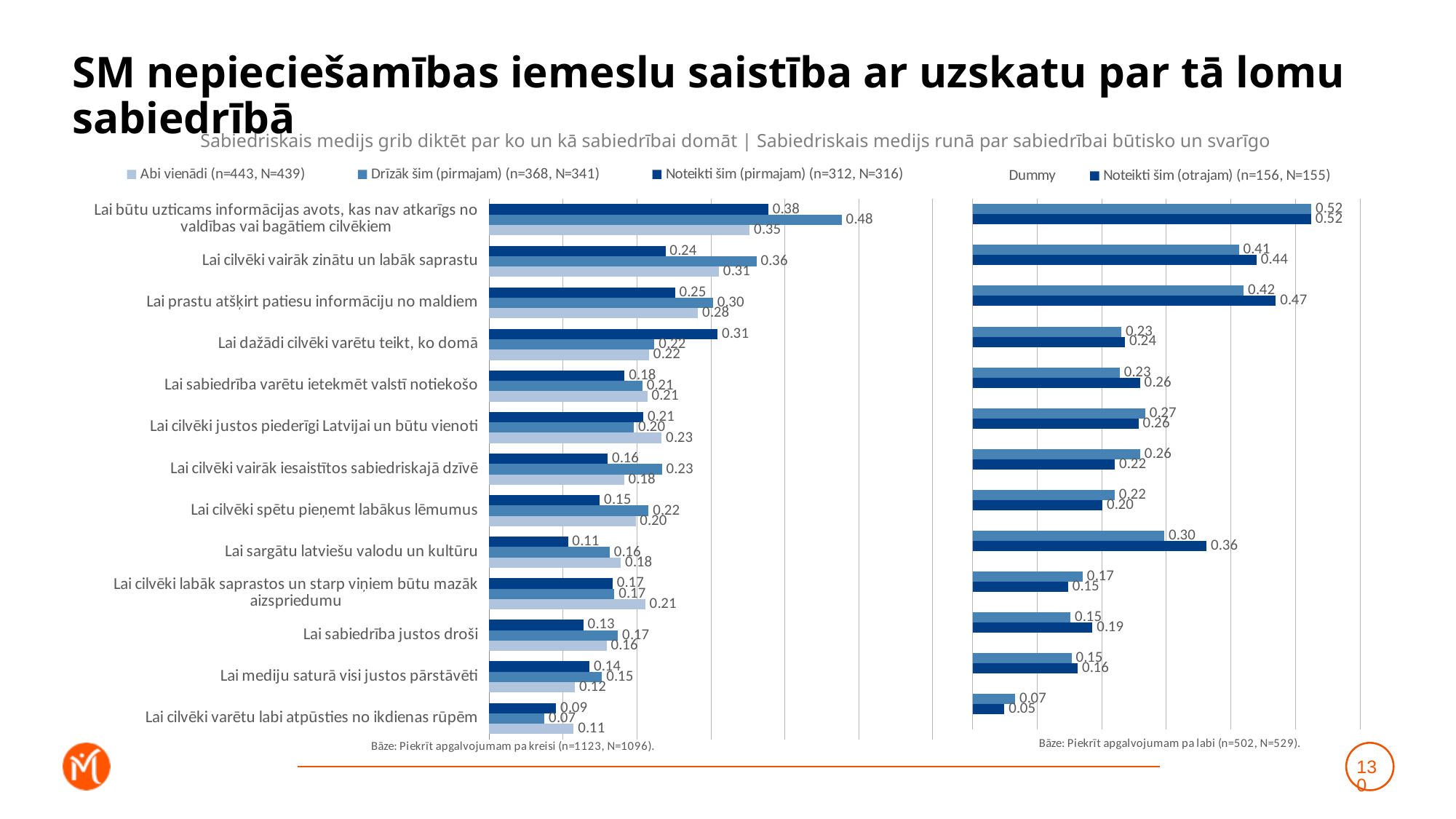
In the left chart, what is the value of 'Drīzāk šim (pirmajam)' for 'Lai cilvēki vairāk zinātu un labāk saprastu'? 0.36 What type of chart is the left chart? Bar chart In the left chart, what is the difference between the 'Drīzāk šim (pirmajam)' and 'Noteikti šim (pirmajam)' values for 'Lai būtu uzticams informācijas avots, kas nav atkarīgs no valdības vai bagātiem cilvēkiem'? 0.10 In the left chart, what is the value of 'Noteikti šim (pirmajam)' for 'Lai būtu uzticams informācijas avots, kas nav atkarīgs no valdības vai bagātiem cilvēkiem'? 0.38 In the left chart, for 'Lai dažādi cilvēki varētu teikt, ko domā', which is larger: 'Noteikti šim (pirmajam)' or 'Abi vienādi'? Noteikti šim (pirmajam) In the right chart, what is the difference between the 'Noteikti šim (otrajam)' values for 'Lai prastu atšķirt patiesu informāciju no maldiem' and 'Lai cilvēki vairāk zinātu un labāk saprastu'? 0.03 In the right chart, which category has the lowest value for 'Noteikti šim (otrajam)'? Lai cilvēki varētu labi atpūsties no ikdienas rūpēm In the right chart, what is the value of 'Noteikti šim (otrajam)' for 'Lai sargātu latviešu valodu un kultūru'? 0.36 How many categories are shown in the left chart? 13 How many series does the legend of the left chart list? 3 In the left chart, what is the value of 'Abi vienādi' for 'Lai cilvēki varētu labi atpūsties no ikdienas rūpēm'? 0.11 In the left chart, which category has the highest value for 'Drīzāk šim (pirmajam)'? Lai būtu uzticams informācijas avots, kas nav atkarīgs no valdības vai bagātiem cilvēkiem